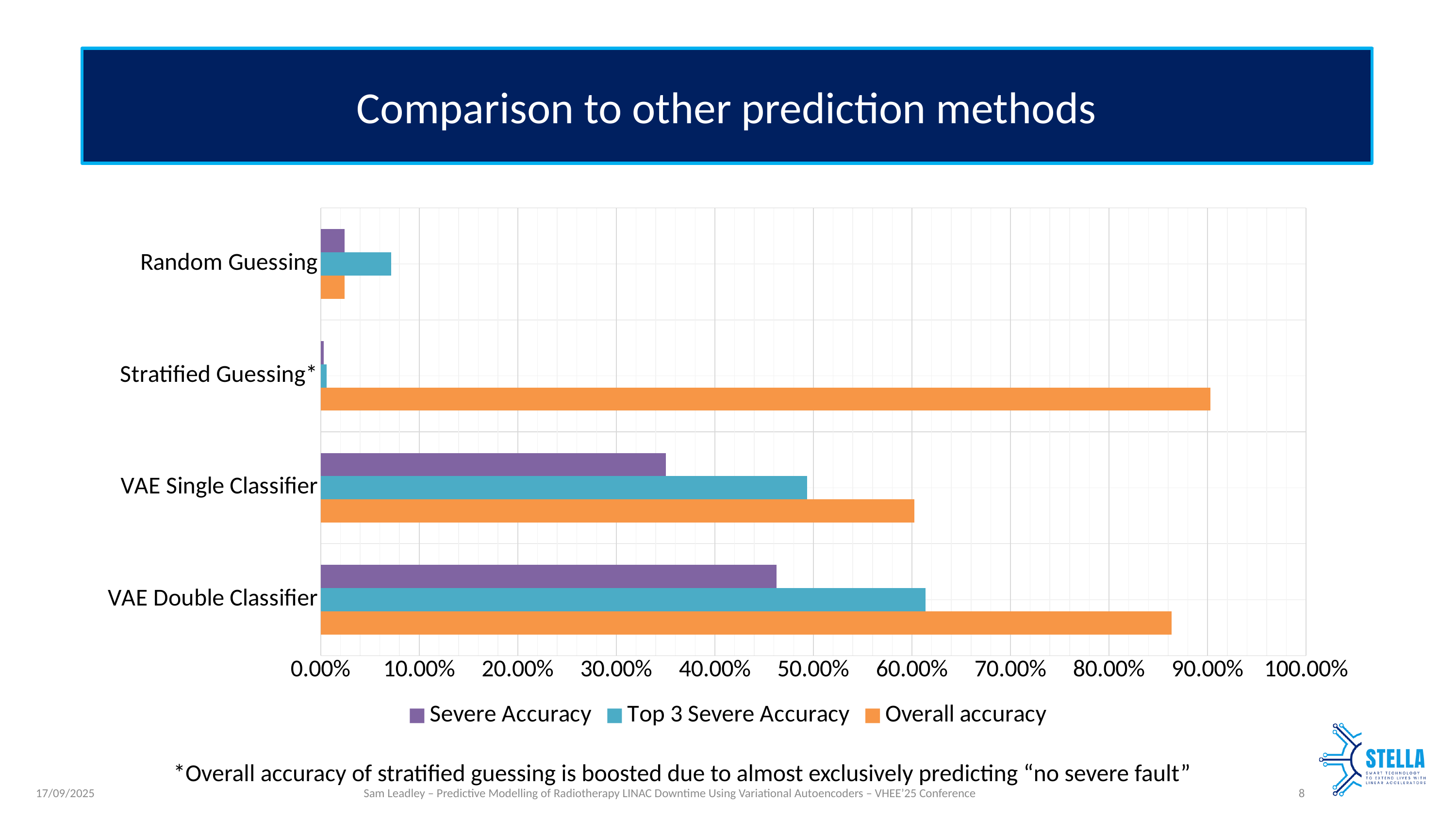
Which series is shown in orange in the legend? Overall accuracy Which prediction method has the lowest Severe Accuracy? Stratified Guessing* Is the Severe Accuracy for VAE Single Classifier greater or less than 40.00%? less How many series does the legend list? 3 Which prediction method has the highest Overall accuracy? Stratified Guessing* Which is larger: the Top 3 Severe Accuracy for VAE Single Classifier or for VAE Double Classifier? VAE Double Classifier How many prediction methods (categories) are shown on the chart? 4 Is the Top 3 Severe Accuracy for VAE Double Classifier greater or less than 50.00%? greater Is the Overall accuracy for VAE Double Classifier greater or less than 80.00%? greater Which prediction method has the highest Severe Accuracy? VAE Double Classifier Which prediction method has the highest Top 3 Severe Accuracy? VAE Double Classifier What kind of chart is shown on the slide? bar chart